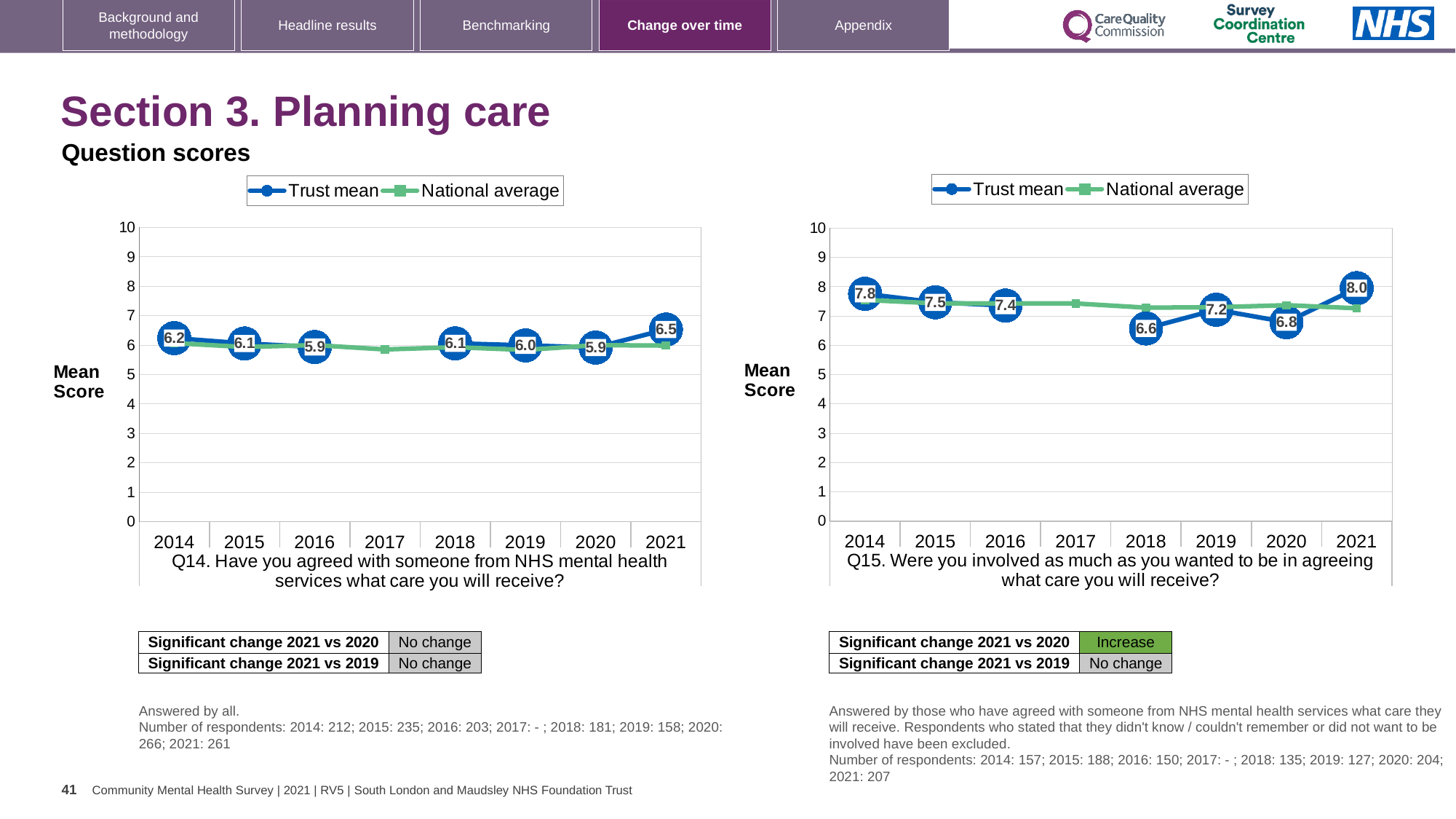
In the Q15 chart on the right, which year has the lowest Trust mean? 2018 In the Q15 chart on the right, is the Trust mean for 2014 or for 2015 larger? 2014 In the Q15 chart on the right, what is the Trust mean for 2018? 6.6 In the Q15 chart on the right, what is the difference between the Trust mean for 2021 and the Trust mean for 2020? 1.2 In the Q14 chart on the left, what is the Trust mean for 2021? 6.5 In the Q14 chart on the left, what is the difference between the Trust mean for 2014 and the Trust mean for 2016? 0.3 What kind of chart is the Q14 chart on the left? Line chart In the Q14 chart on the left, which year has the highest Trust mean? 2021 What is the label of the y axis on the Q15 chart on the right? Mean Score In the Q14 chart on the left, is the National average for 2017 greater or less than 7? less How many series does the legend of the Q15 chart on the right list? 2 How many years are shown on the x axis of the Q14 chart on the left? 8